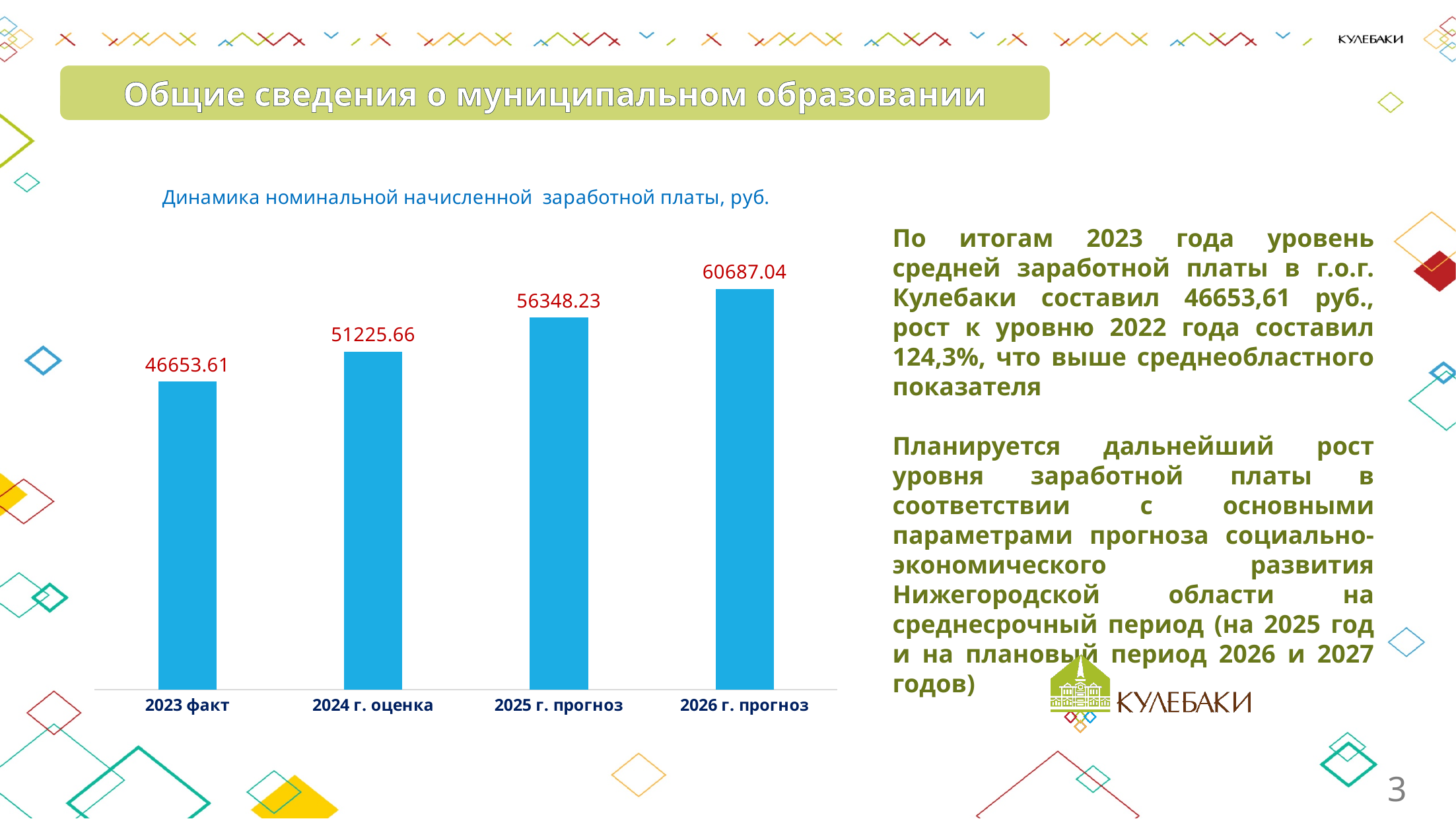
What is the difference between the values for 2026 г. прогноз and 2023 факт? 14033.43 What is the difference between the values for 2025 г. прогноз and 2024 г. оценка? 5122.57 Which category has the lowest value? 2023 факт Do the values rise or fall from 2023 факт to 2026 г. прогноз? rise What is the value for 2026 г. прогноз? 60687.04 Which category has the highest value? 2026 г. прогноз Which is larger, the value for 2024 г. оценка or the value for 2025 г. прогноз? 2025 г. прогноз What kind of chart is shown on the slide? bar chart What is the value for 2024 г. оценка? 51225.66 How many categories are shown on the x axis? 4 What is the value for 2023 факт? 46653.61 What is the value for 2025 г. прогноз? 56348.23